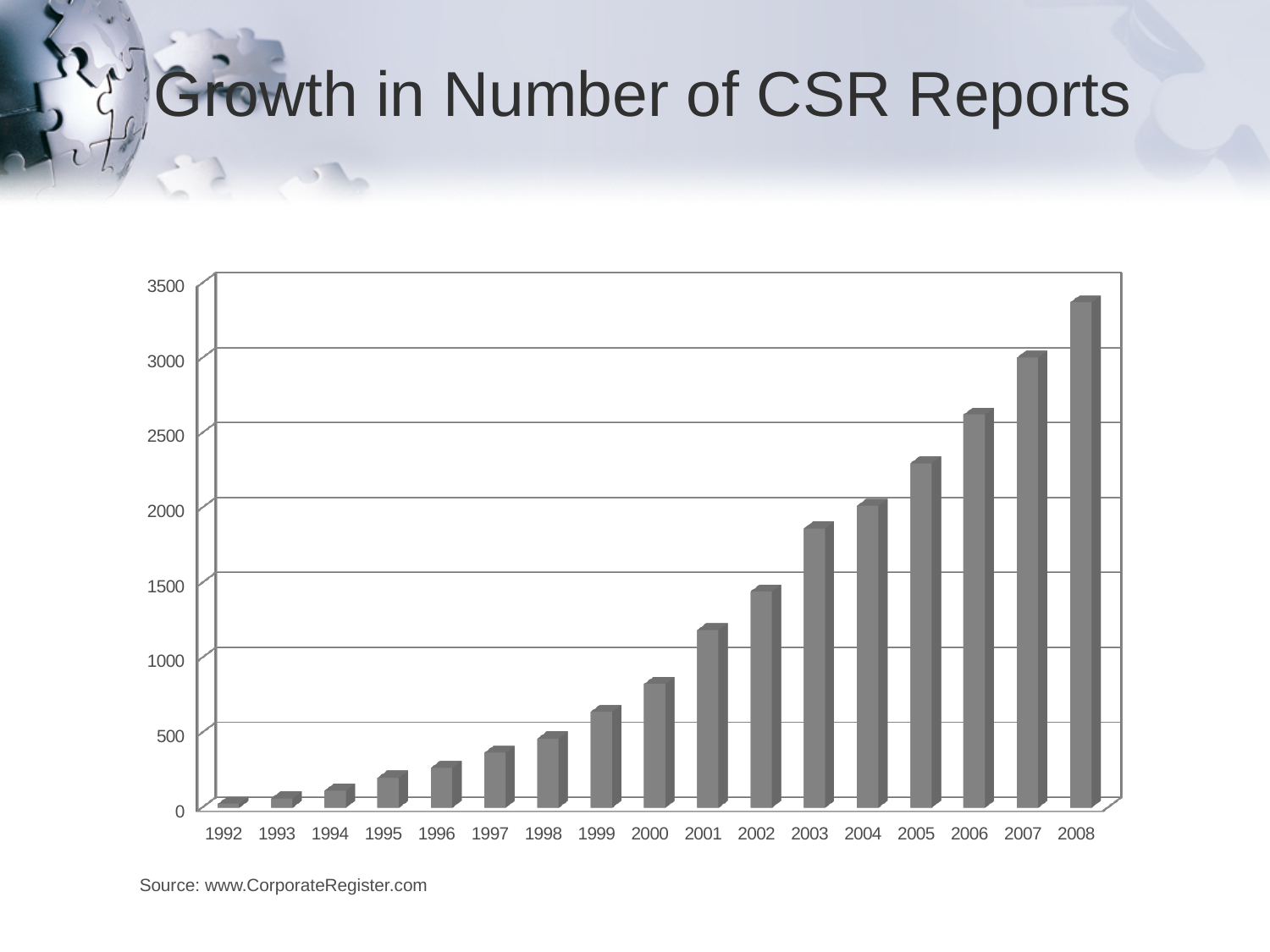
Which year has a larger value, 2003 or 2000? 2003 How many years are shown on the x axis of the chart? 17 Is the value for 2005 greater or less than 2500? less Which year has the highest number of CSR reports? 2008 What is the title of the slide containing the chart? Growth in Number of CSR Reports Is the value for 1999 greater or less than 500? greater Is the value for 2006 greater or less than 2500? greater Which year has the lowest number of CSR reports? 1992 What kind of chart is shown on the slide? Bar chart Do the values rise or fall from 1992 to 2008? Rise